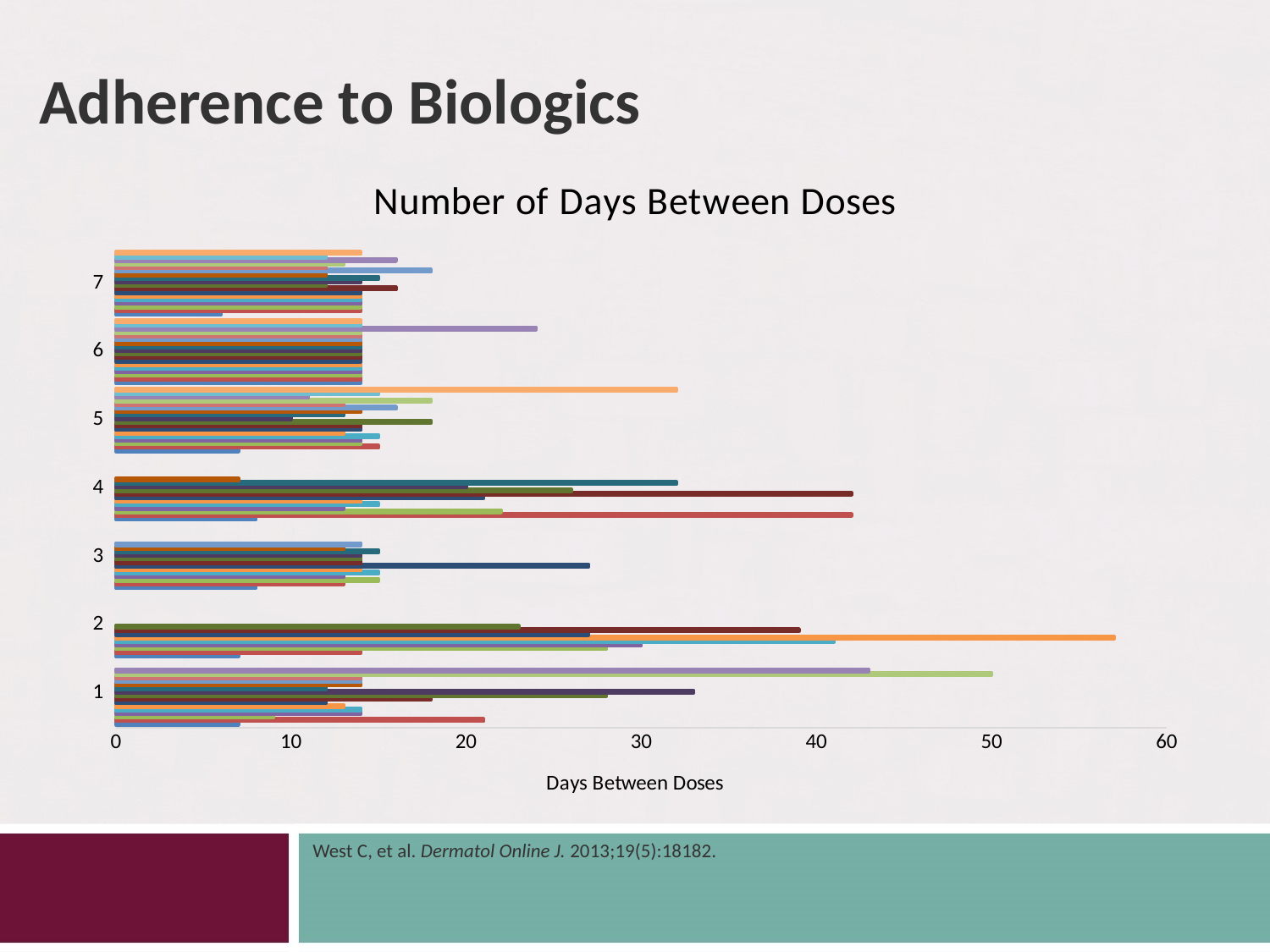
Is the longest bar in category 6 greater or less than 30 days? less Is the longest bar in category 1 greater or less than 40 days? greater Is the longest bar in category 4 greater or less than 30 days? greater What is the label on the horizontal axis of the chart? Days Between Doses Which numbered category contains the single longest bar in the chart? 2 How many numbered categories are shown on the vertical axis of the chart? 7 What is the maximum value shown on the horizontal axis of the chart? 60 What kind of chart is shown on the slide? bar chart What is the title of the chart? Number of Days Between Doses